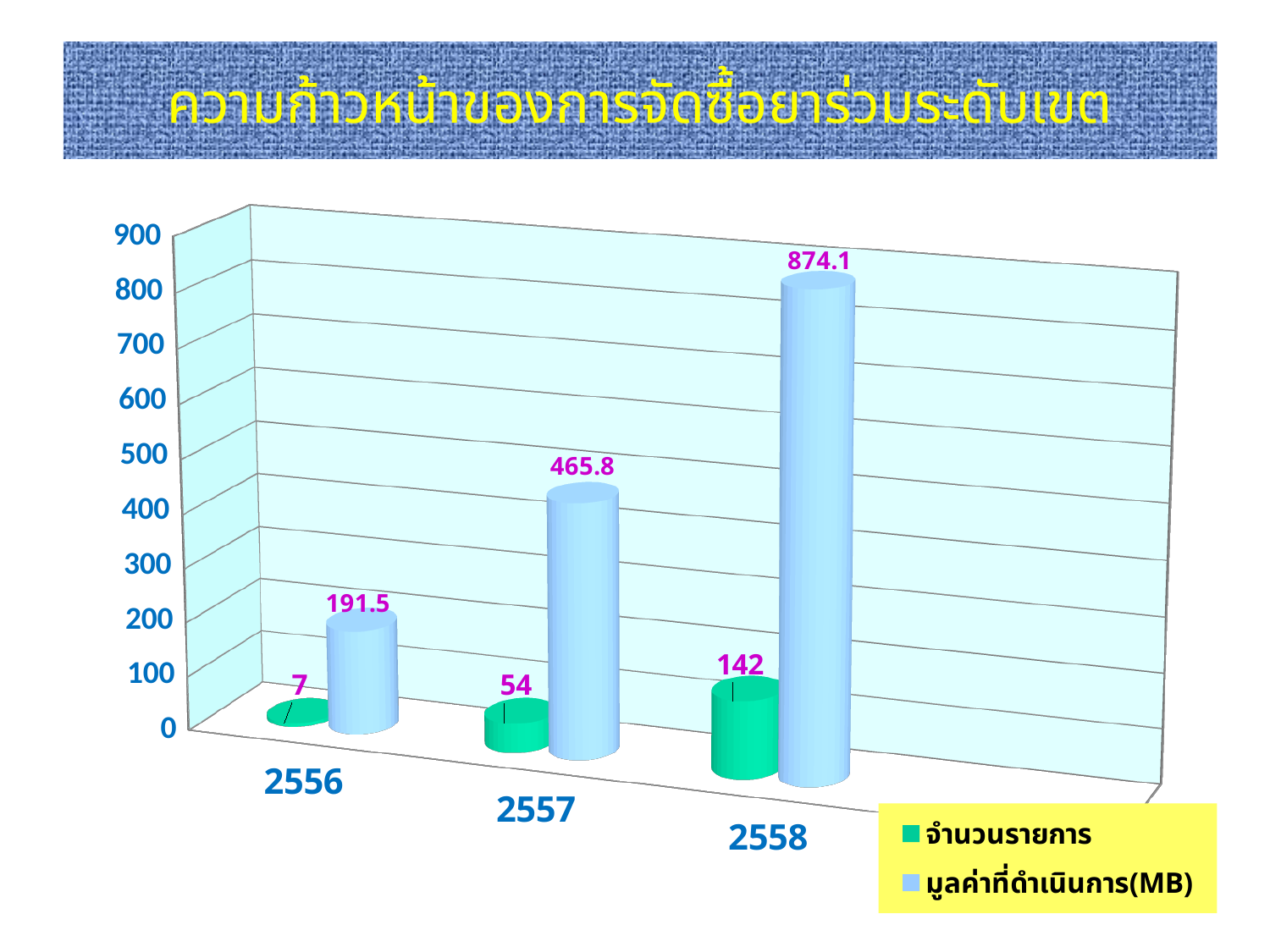
What kind of chart is shown on the slide? Bar chart What is the value of มูลค่าที่ดำเนินการ(MB) for 2556? 191.5 What is the value of จำนวนรายการ for 2557? 54 Which year has the lowest value for มูลค่าที่ดำเนินการ(MB)? 2556 How many years are shown on the x axis? 3 How many series does the legend list? 2 What is the difference between the จำนวนรายการ values for 2558 and 2556? 135 Do the values for มูลค่าที่ดำเนินการ(MB) rise or fall from 2556 to 2558? Rise What is the value of มูลค่าที่ดำเนินการ(MB) for 2558? 874.1 Which is larger: มูลค่าที่ดำเนินการ(MB) for 2557 or for 2556? 2557 What is the difference between the มูลค่าที่ดำเนินการ(MB) values for 2558 and 2557? 408.3 Which year has the highest value for จำนวนรายการ? 2558